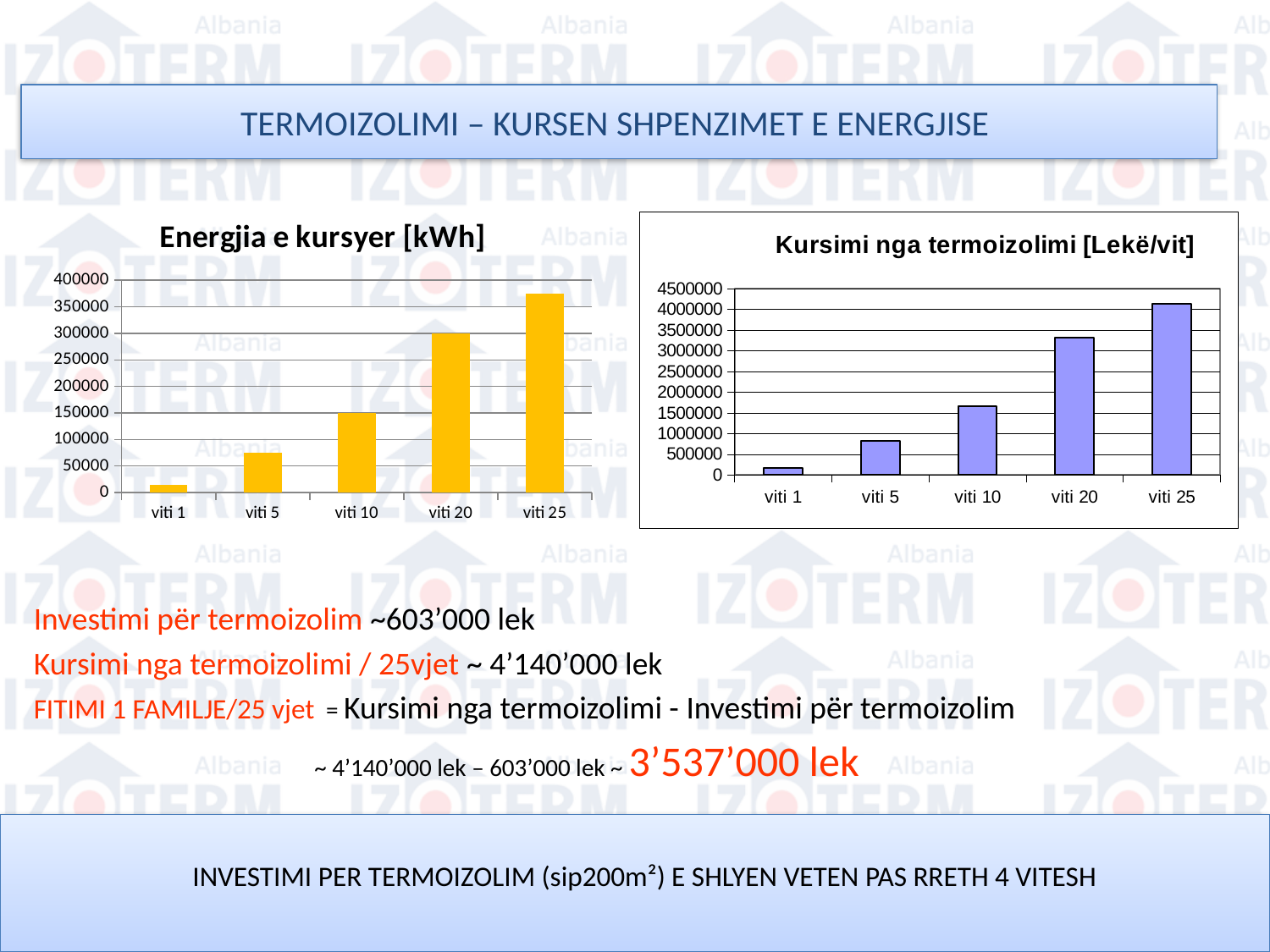
How many categories are shown on the x axis of the 'Energjia e kursyer [kWh]' chart? 5 What kind of chart is the 'Energjia e kursyer [kWh]' chart on the left? bar chart In the 'Energjia e kursyer [kWh]' chart, what is the value for viti 20? 300000 In the 'Energjia e kursyer [kWh]' chart, which category has the highest value? viti 25 In the 'Kursimi nga termoizolimi [Lekë/vit]' chart, which category has the highest value? viti 25 In the 'Kursimi nga termoizolimi [Lekë/vit]' chart, which is larger, the value for viti 5 or the value for viti 10? viti 10 In the 'Energjia e kursyer [kWh]' chart, is the value for viti 5 greater or less than 100000? less In the 'Energjia e kursyer [kWh]' chart, what is the value for viti 10? 150000 In the 'Kursimi nga termoizolimi [Lekë/vit]' chart, is the value for viti 20 greater or less than 3000000? greater In the 'Energjia e kursyer [kWh]' chart, which category has the lowest value? viti 1 In the 'Kursimi nga termoizolimi [Lekë/vit]' chart, is the value for viti 10 greater or less than 2000000? less In the 'Energjia e kursyer [kWh]' chart, do the values rise or fall from viti 1 to viti 25? rise